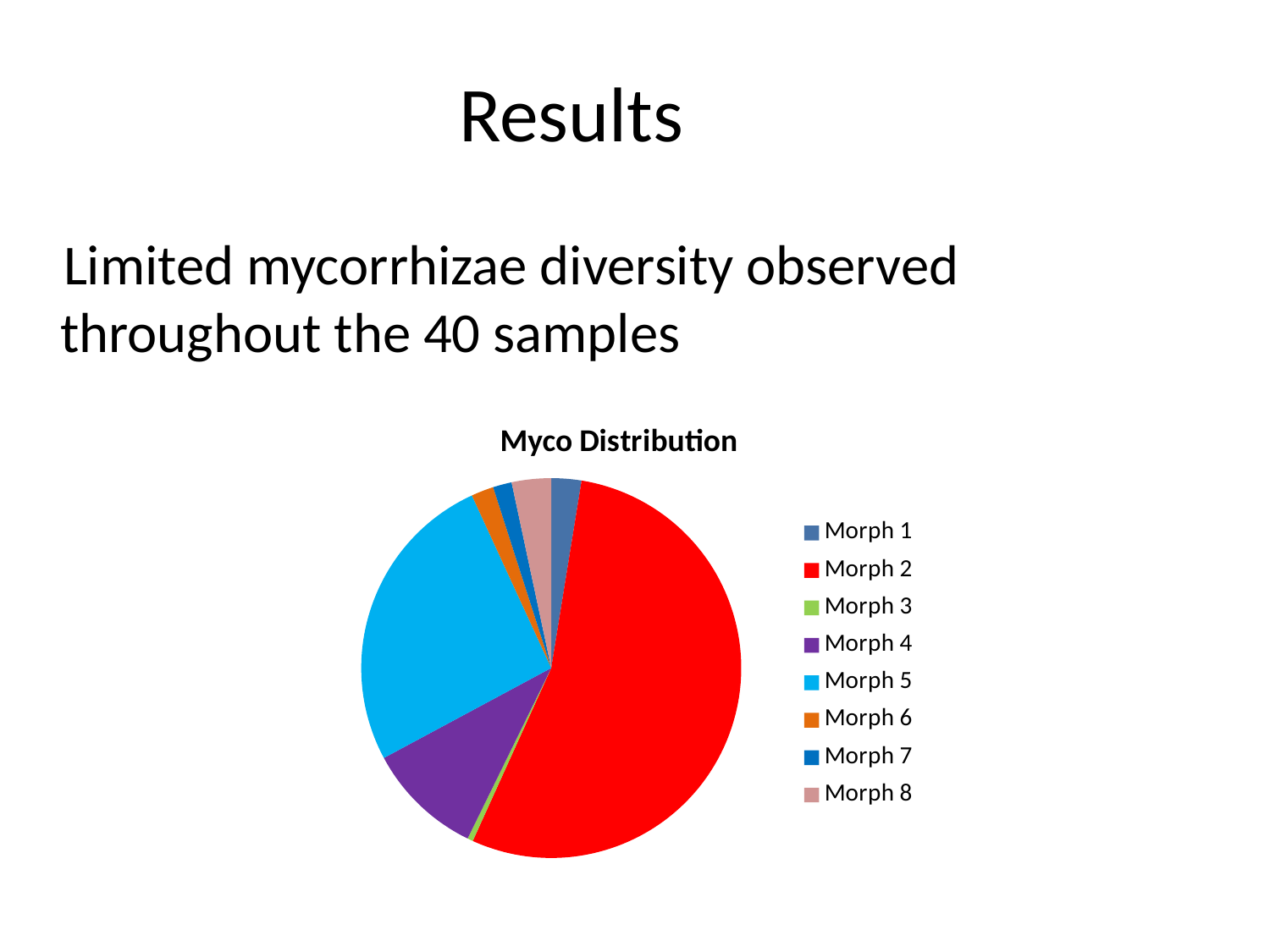
Which morph has the smallest slice in the Myco Distribution pie chart? Morph 3 What is the title of the chart? Myco Distribution How many slices does the Myco Distribution pie chart have? 8 Which slice is larger in the Myco Distribution chart, Morph 4 or Morph 8? Morph 4 Which slice is larger in the Myco Distribution chart, Morph 5 or Morph 4? Morph 5 Which slice is larger in the Myco Distribution chart, Morph 8 or Morph 7? Morph 8 Which morph has the largest slice in the Myco Distribution pie chart? Morph 2 What colour is the Morph 2 slice in the Myco Distribution chart? red What kind of chart is shown on the slide? pie chart How many entries does the legend of the Myco Distribution chart list? 8